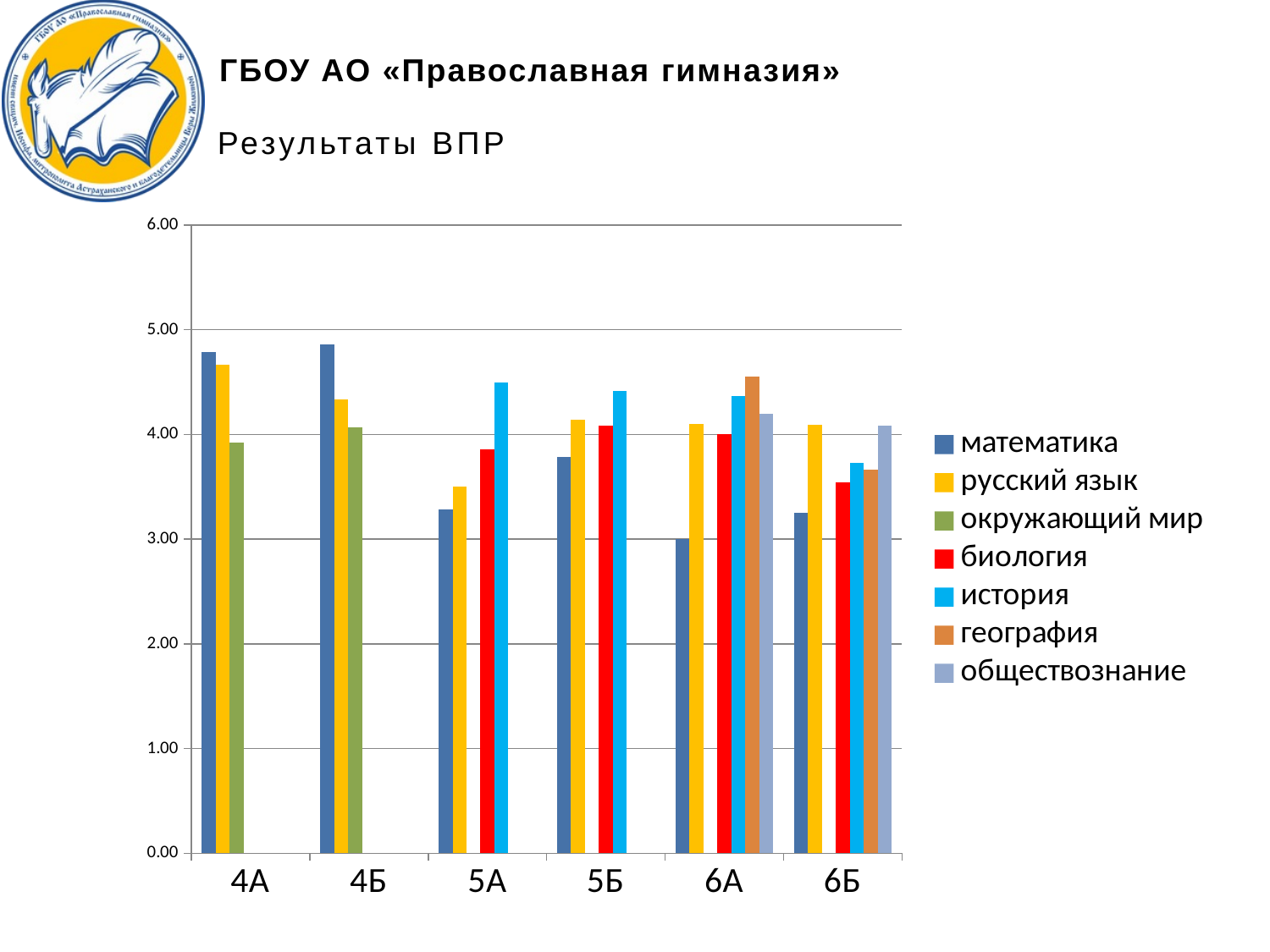
Is the value for математика in class 6А greater or less than 4.00? less In class 5А, which subject has the highest value? история How many series does the legend list? 7 What kind of chart is shown on the slide? bar chart In class 6А, which subject has the lowest value? математика Is the value for математика in class 4Б greater or less than 4.00? greater Is the value for история in class 5А greater or less than 4.00? greater How many classes (categories) are shown on the x axis? 6 Which colour represents биология in the legend? red In class 4А, which is larger: математика or окружающий мир? математика In class 6А, which subject has the highest value? география